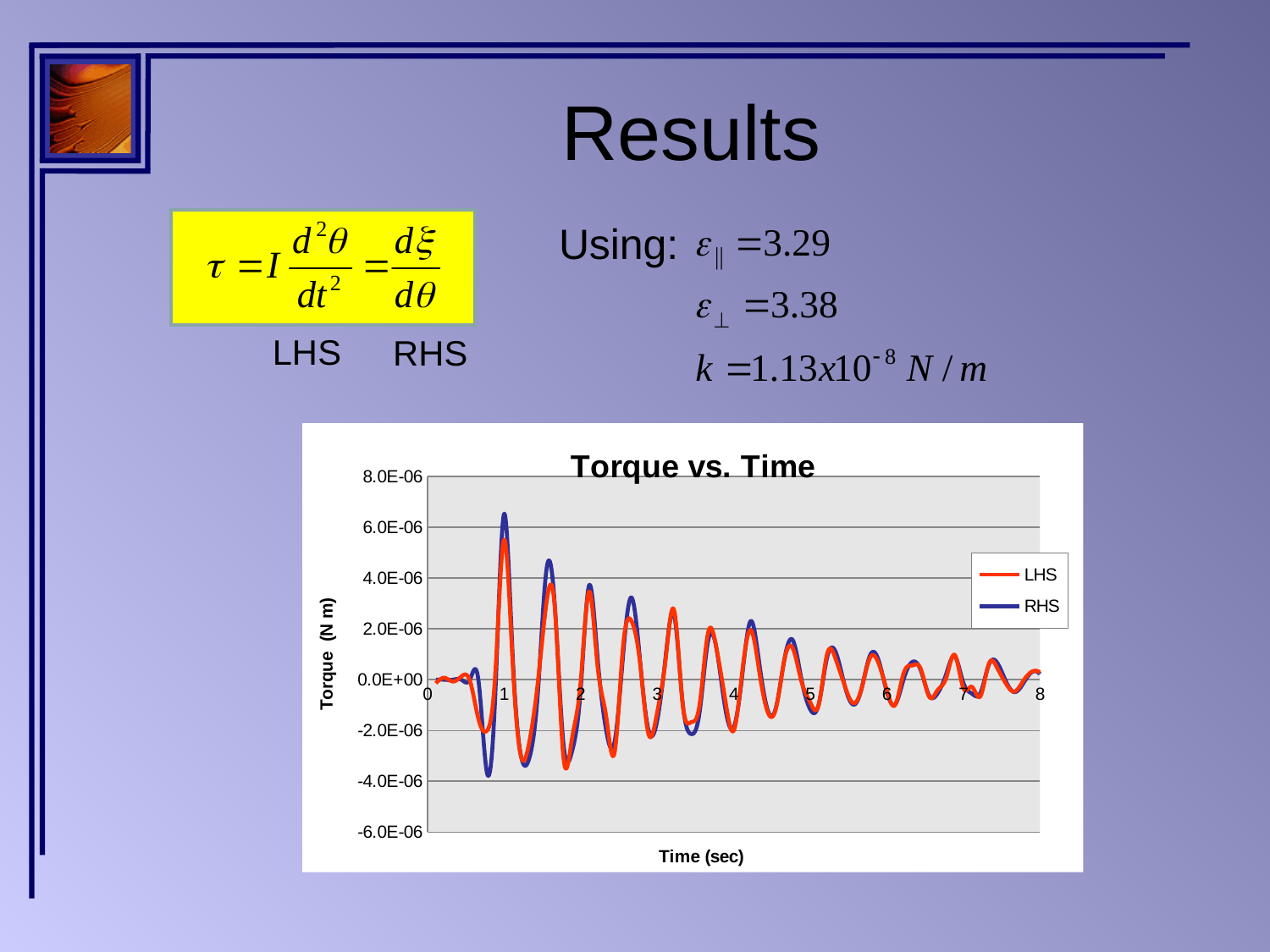
Is the lowest trough of the RHS series (near time 0.7 sec) greater or less than -2.0E-06? less Is the highest peak of the LHS series greater or less than 6.0E-06? less What kind of chart is shown on the slide? line chart What is the title of the chart on the slide? Torque vs. Time How many series does the legend of the Torque vs. Time chart list? 2 Which series in the chart reaches the higher peak torque near time 1 sec, LHS or RHS? RHS What is the label of the vertical axis of the chart? Torque (N m) Is the highest peak of the RHS series greater or less than 6.0E-06? greater What is the largest value shown on the Time (sec) axis of the chart? 8 What is the lowest tick value shown on the Torque axis of the chart? -6.0E-06 Does the amplitude of the torque oscillations increase or decrease as time goes from 0 to 8 sec? decrease